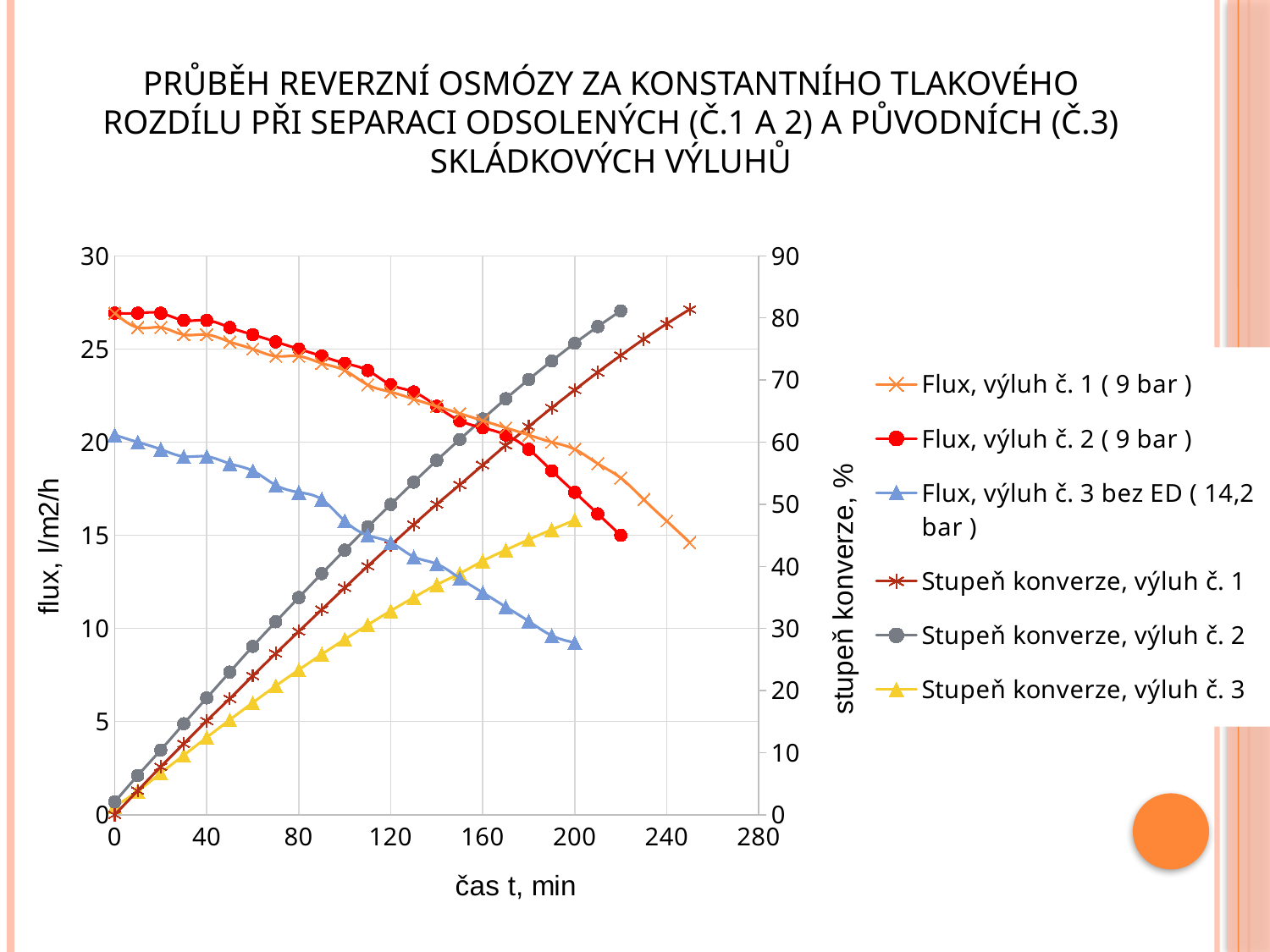
Does the series 'Stupeň konverze, výluh č. 2' rise or fall as time increases? rise What kind of chart is shown on the slide? line chart Is the value of 'Stupeň konverze, výluh č. 3' at 200 min greater or less than 50? less At 200 min, which is higher: 'Stupeň konverze, výluh č. 2' or 'Stupeň konverze, výluh č. 3'? Stupeň konverze, výluh č. 2 What is the title of the x axis? čas t, min How many series does the legend list? 6 Which flux series has the lowest value at 0 min? Flux, výluh č. 3 bez ED ( 14,2 bar ) Does the series 'Flux, výluh č. 2 ( 9 bar )' rise or fall as time increases? fall Is the value of 'Flux, výluh č. 3 bez ED ( 14,2 bar )' at 200 min greater or less than 10? less Is the value of 'Flux, výluh č. 2 ( 9 bar )' at 0 min greater or less than 25? greater At 0 min, which has the higher flux: výluh č. 2 or výluh č. 3? výluh č. 2 What is the title of the right-hand y axis? stupeň konverze, %